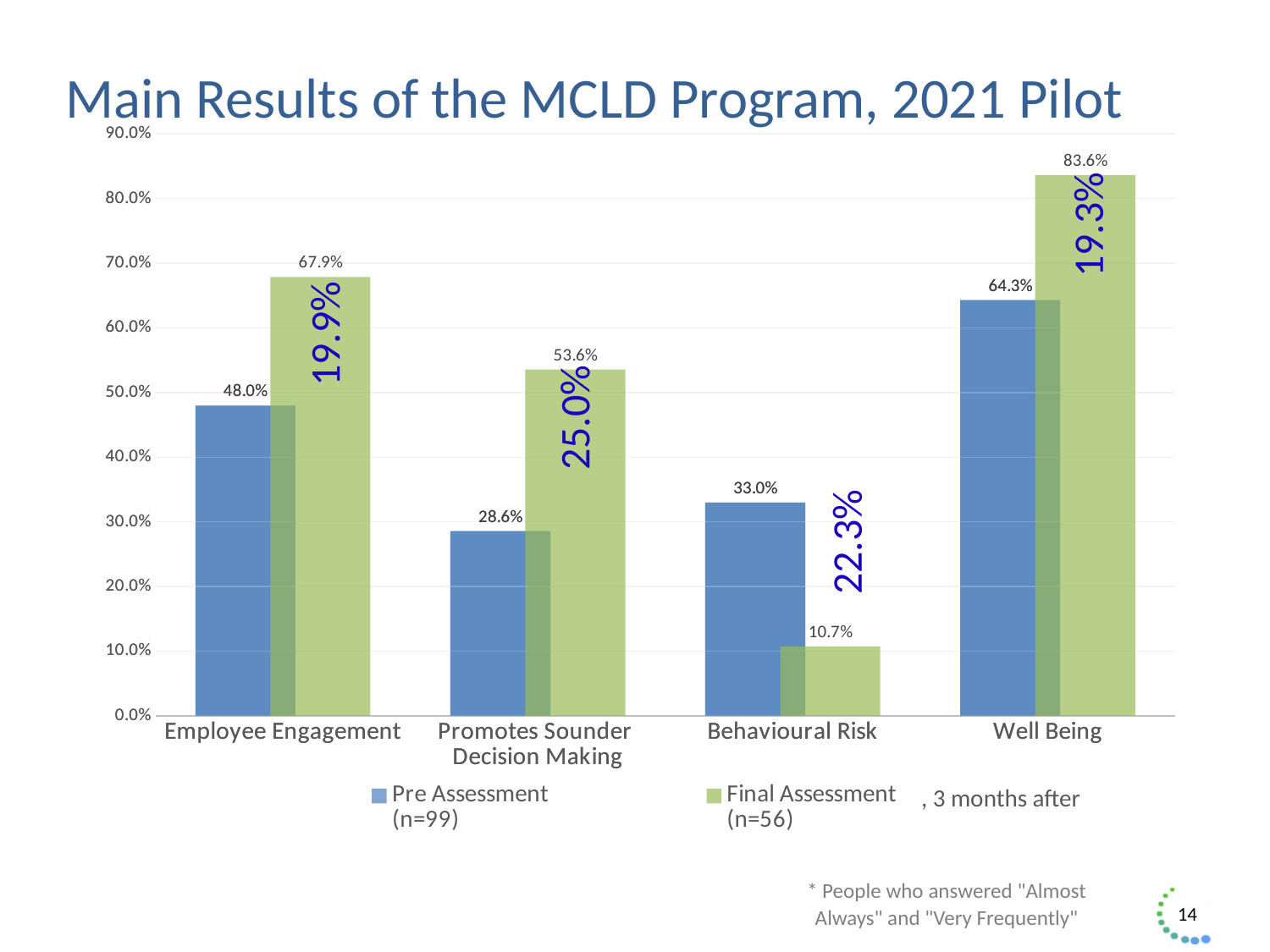
What is the difference between the Final Assessment and Pre Assessment values for Employee Engagement? 19.9% What is the sample size (n) for the Final Assessment series according to the legend? n=56 How many series does the legend list? 2 How many categories are shown on the x axis? 4 What kind of chart is shown on the slide? Bar chart Which category has the highest Final Assessment value? Well Being What is the Final Assessment value for Behavioural Risk? 10.7% What is the Final Assessment value for Well Being? 83.6% Which is larger for Behavioural Risk: the Pre Assessment value or the Final Assessment value? Pre Assessment Which category has the lowest Pre Assessment value? Promotes Sounder Decision Making What is the Pre Assessment value for Promotes Sounder Decision Making? 28.6% What is the Pre Assessment value for Employee Engagement? 48.0%